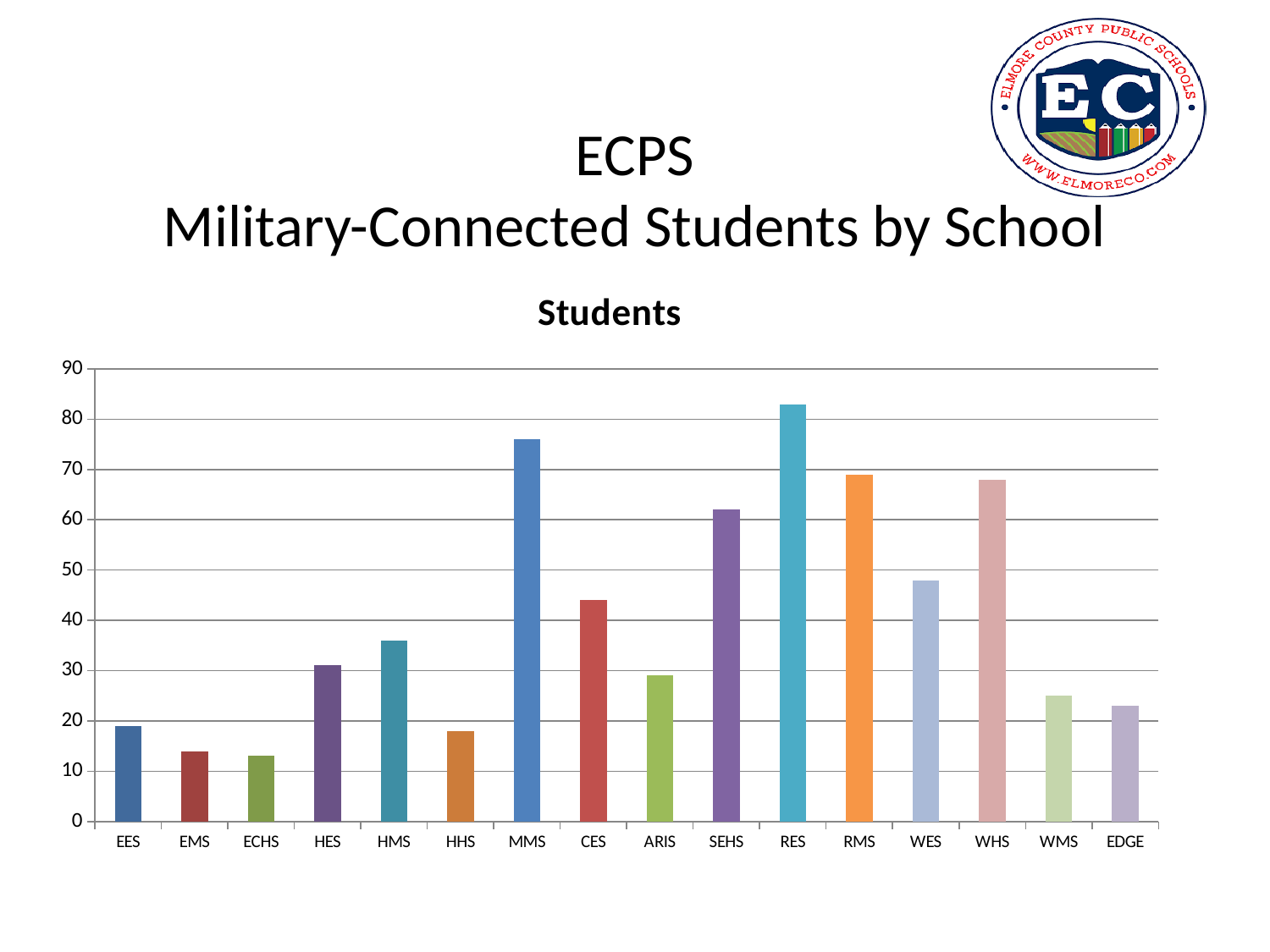
Is the value for SEHS greater or less than 60? greater Is the value for HMS greater or less than 40? less Is the value for WES greater or less than 50? less Which has more military-connected students, HMS or HES? HMS How many schools are shown on the x axis of the chart? 16 What kind of chart is shown on the slide? bar chart Which school has the highest number of military-connected students? RES Which has more military-connected students, MMS or SEHS? MMS What is the title of the chart? Students